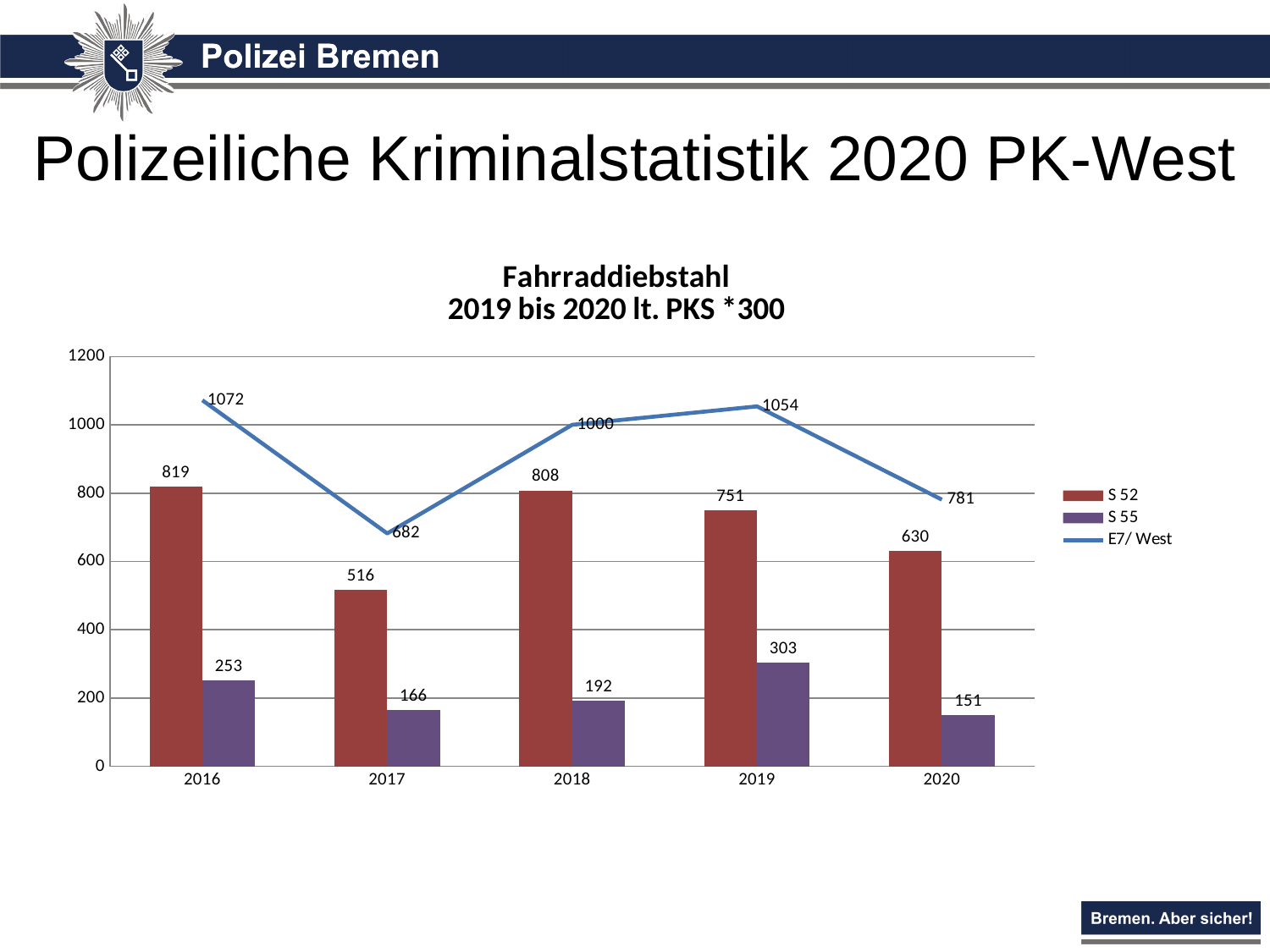
Which is larger, the S 55 value in 2016 or in 2018? 2016 In which year is the S 52 value lowest? 2020 What kind of chart is this? Combined bar and line chart What is the value for S 55 in 2019? 303 How many series does the legend list? 3 What is the title of the chart? Fahrraddiebstahl 2019 bis 2020 lt. PKS *300 What is the value for S 52 in 2016? 819 Does the S 55 value rise or fall from 2019 to 2020? Fall What is the difference between the S 52 value in 2016 and in 2020? 189 In which year is the E7/ West value highest? 2016 What is the value for E7/ West in 2017? 682 How many years are shown on the x axis? 5